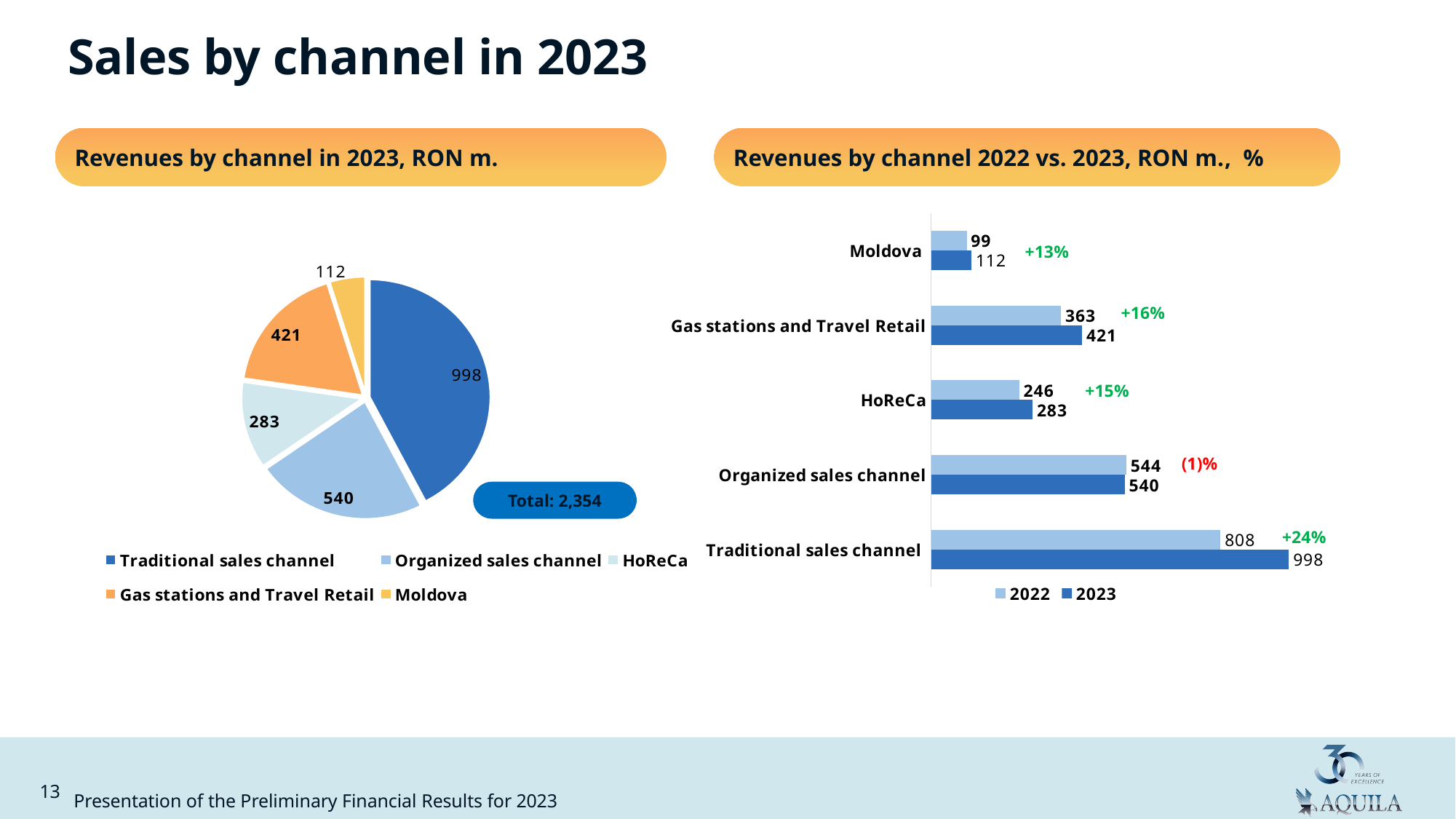
In the pie chart 'Revenues by channel in 2023, RON m.', what is the value for the Traditional sales channel? 998 In the bar chart 'Revenues by channel 2022 vs. 2023, RON m., %', which channel shows a negative percentage change? Organized sales channel In the bar chart 'Revenues by channel 2022 vs. 2023, RON m., %', what percentage change is shown for the Traditional sales channel? +24% In the bar chart 'Revenues by channel 2022 vs. 2023, RON m., %', what was the 2022 value for Gas stations and Travel Retail? 363 In the bar chart 'Revenues by channel 2022 vs. 2023, RON m., %', how many series does the legend list? 2 In the pie chart 'Revenues by channel in 2023, RON m.', how many slices are there? 5 In the bar chart 'Revenues by channel 2022 vs. 2023, RON m., %', is the 2022 value for HoReCa larger or smaller than the 2023 value? smaller In the bar chart 'Revenues by channel 2022 vs. 2023, RON m., %', what is the difference between the 2023 and 2022 values for Moldova? 13 In the pie chart 'Revenues by channel in 2023, RON m.', what is the difference between the Organized sales channel and HoReCa values? 257 In the pie chart 'Revenues by channel in 2023, RON m.', what total is shown on the slide? Total: 2,354 In the pie chart 'Revenues by channel in 2023, RON m.', which channel has the smallest slice? Moldova What type of chart is shown on the right side of the slide? bar chart